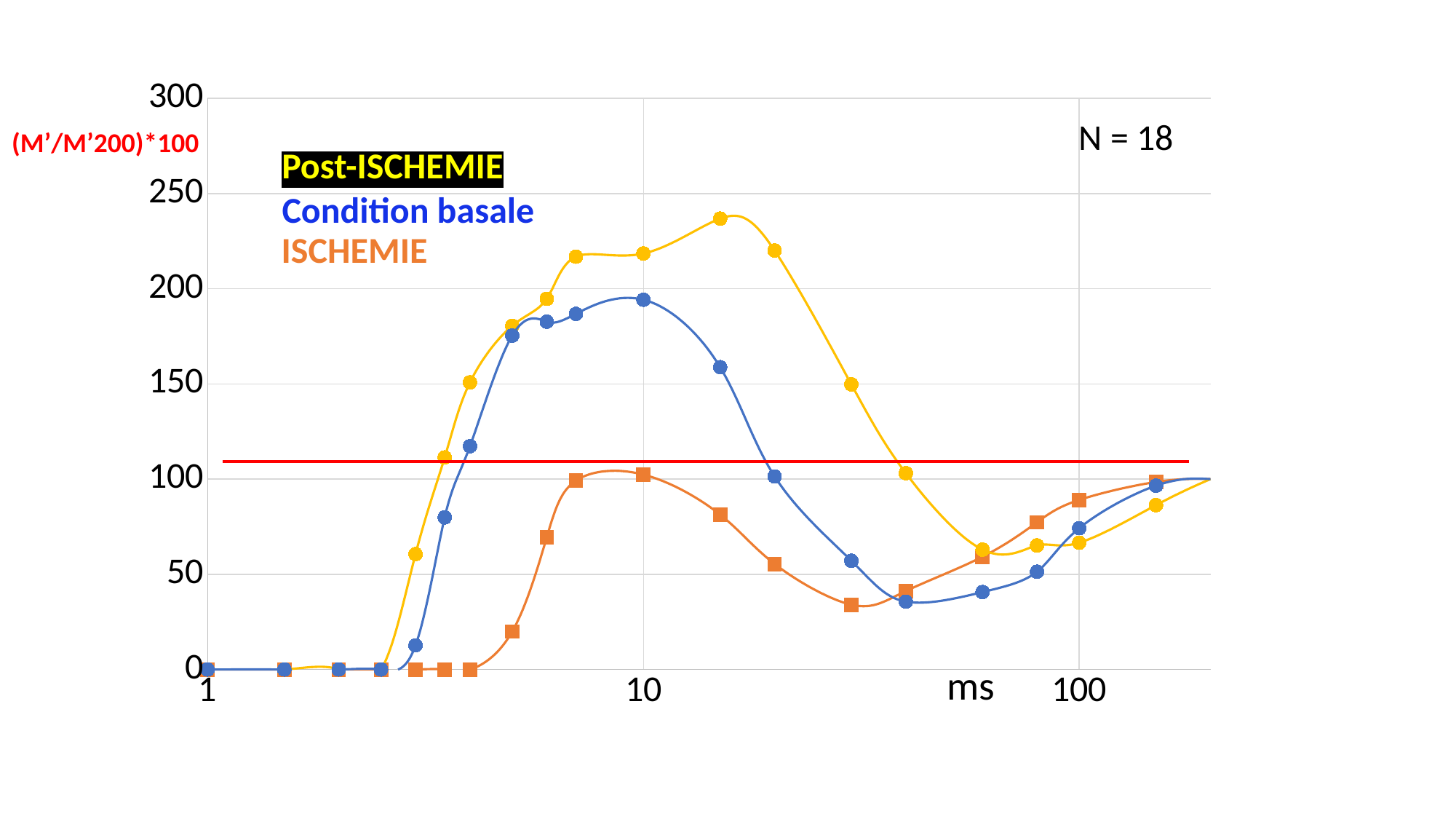
Which series reaches the highest peak value? Post-ISCHEMIE What is the sample size shown on the chart? N = 18 What is the value of the Condition basale series at 1 ms? 0 Is the value of Post-ISCHEMIE at 10 ms greater or less than 200? greater Is the value of Condition basale at 10 ms greater or less than 200? less At 100 ms, which series has the larger value, ISCHEMIE or Post-ISCHEMIE? ISCHEMIE How many series does the legend list? 3 Does the Condition basale series rise or fall between 10 ms and 40 ms? fall What kind of chart is shown on the slide? line chart At 10 ms, which series has the larger value, Post-ISCHEMIE or Condition basale? Post-ISCHEMIE Is the value of ISCHEMIE at 10 ms greater or less than 50? greater Which series has the lowest peak value? ISCHEMIE